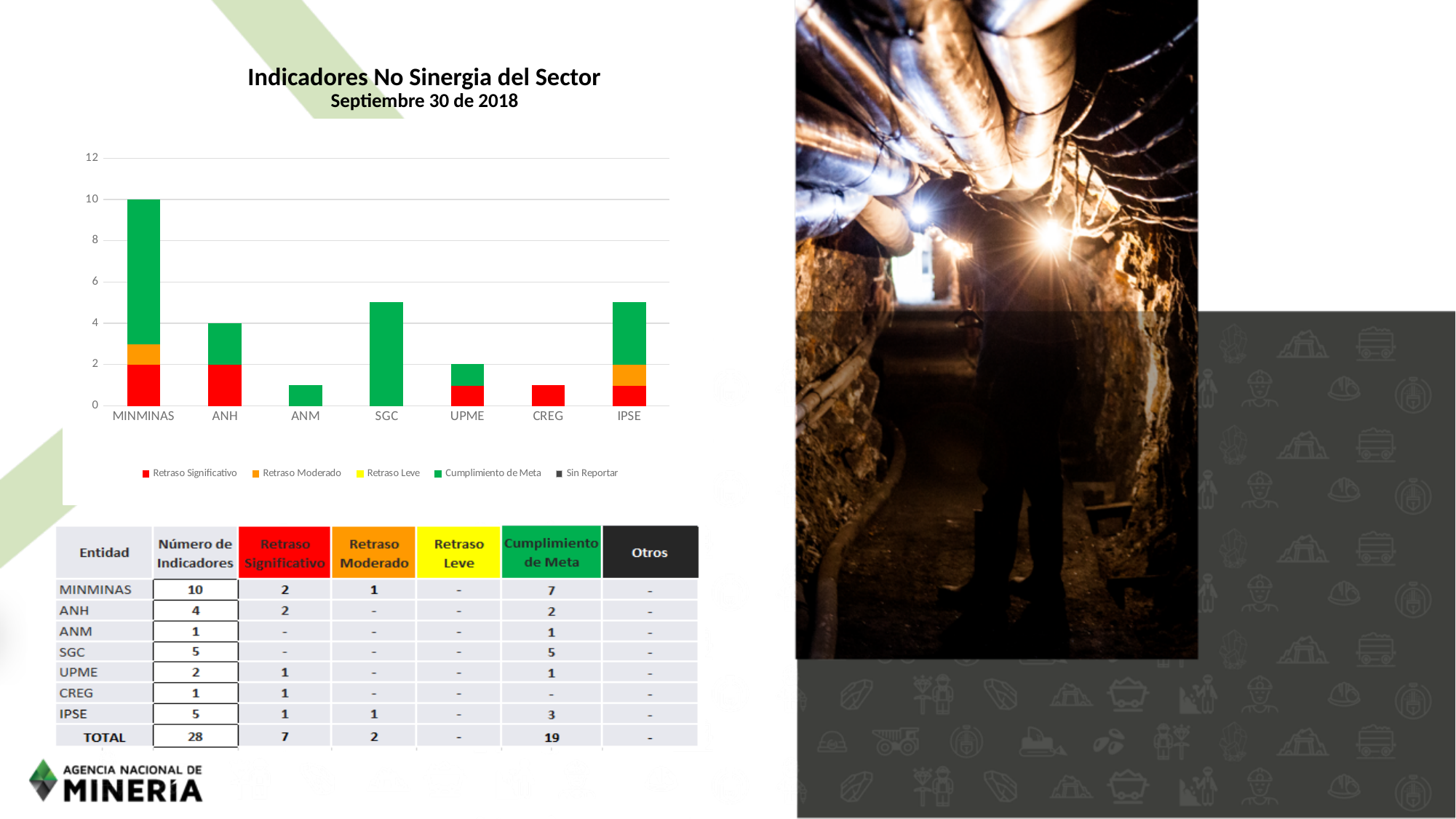
How many series does the chart legend list? 5 Is the total bar height for CREG greater or less than 2? less What is the total number of indicators for IPSE? 5 What colour represents Cumplimiento de Meta in the chart? green How many entities are shown along the x axis of the chart? 7 Is the total bar height for MINMINAS greater or less than 8? greater Which bar is taller, SGC or ANH? SGC Which entity has the tallest bar in the chart? MINMINAS What is the total number of indicators for ANH? 4 What is the total number of indicators for MINMINAS? 10 What is the Retraso Significativo value for ANH? 2 What kind of chart is shown on the slide? bar chart